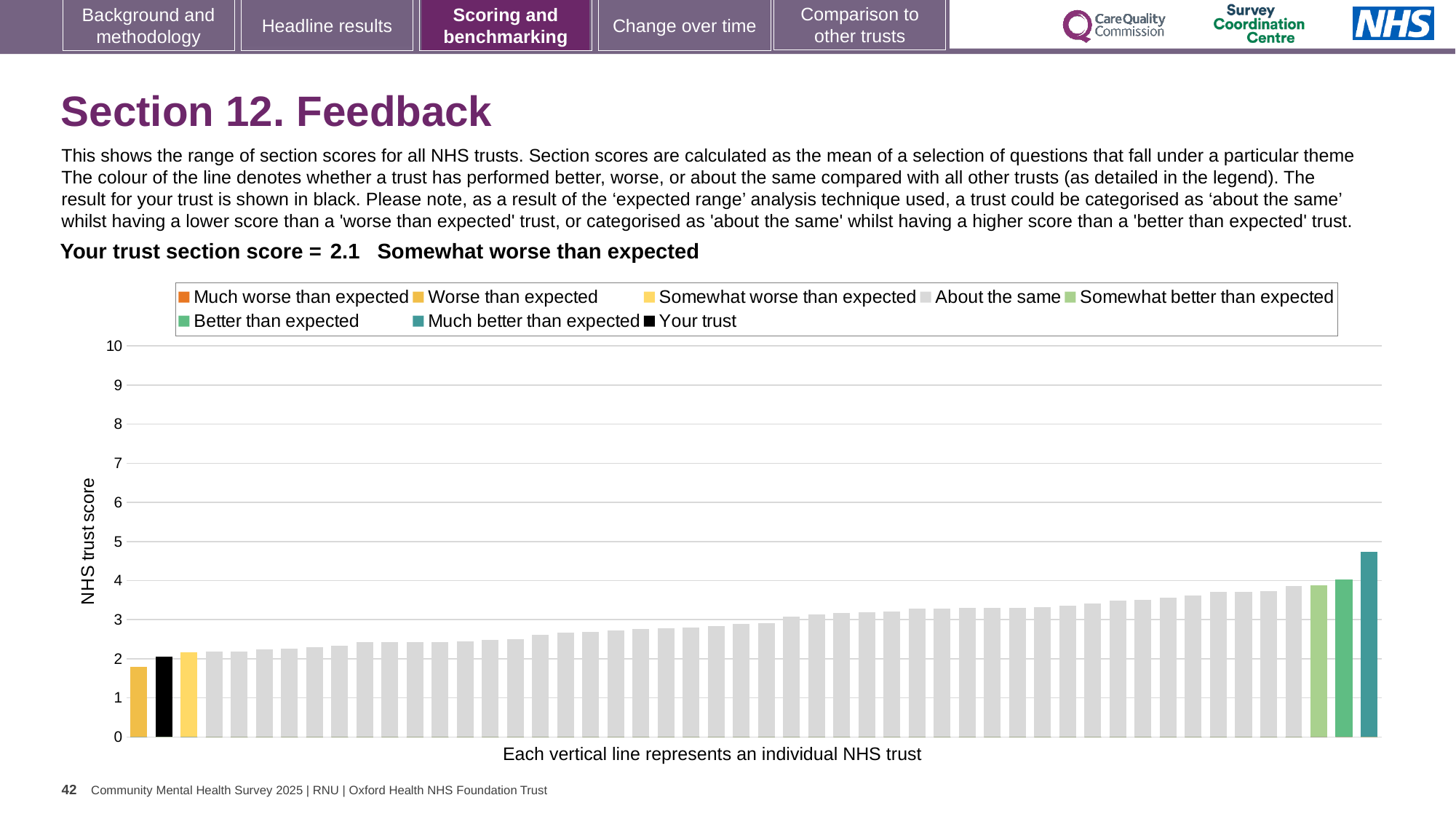
How many entries does the chart legend list? 8 Is the value of the shortest bar greater or less than 2? less Which legend category does the tallest bar belong to? Much better than expected What type of chart is shown on the slide? bar chart Is the bar for your trust higher or lower than the first (leftmost) bar? higher Which legend category does the shortest bar belong to? Worse than expected What colour is the bar representing your trust? black What is the section score for your trust shown on the slide? 2.1 What is the label on the vertical axis of the chart? NHS trust score Is the value for your trust greater or less than 3? less Do the bar values rise or fall from left to right along the x axis? rise Is the value of the tallest bar greater or less than 4? greater